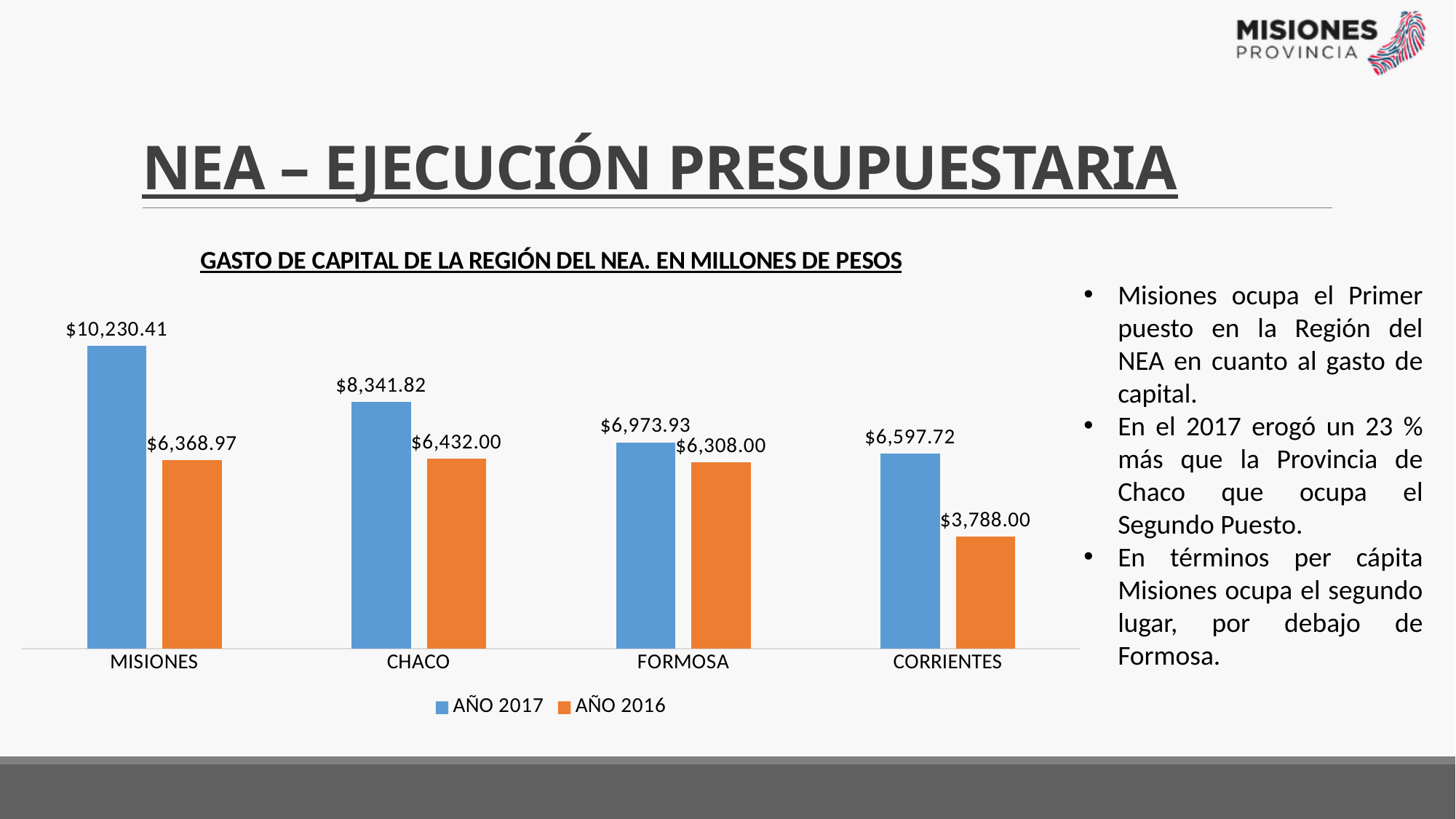
Which province has the lowest AÑO 2016 value? CORRIENTES What is the AÑO 2016 value for CORRIENTES? $3,788.00 What is the difference between the AÑO 2017 and AÑO 2016 values for MISIONES? $3,861.44 What is the AÑO 2017 value for MISIONES? $10,230.41 What type of chart is shown on the slide? Bar chart Which is larger, the AÑO 2016 value for FORMOSA or the AÑO 2016 value for CORRIENTES? FORMOSA How many provinces are shown on the x axis of the chart? 4 What is the AÑO 2017 value for FORMOSA? $6,973.93 Which province has the highest AÑO 2017 value? MISIONES How many series does the chart legend list? 2 What is the difference between the AÑO 2017 and AÑO 2016 values for CORRIENTES? $2,809.72 What is the AÑO 2016 value for CHACO? $6,432.00